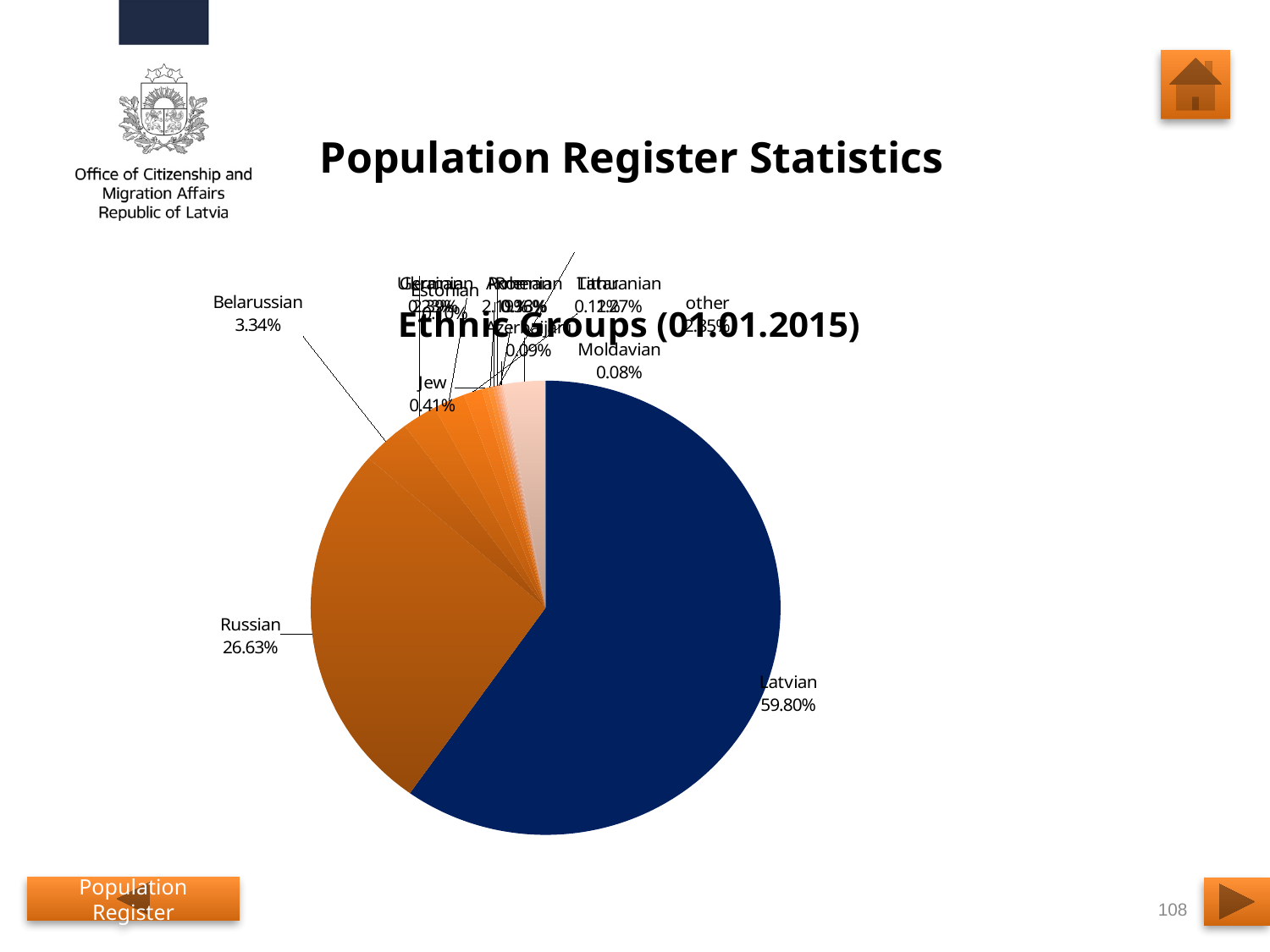
What share of the pie is Russian? 26.63% What kind of chart is shown on the slide? pie chart What is the value shown for Moldavian? 0.08% Which is larger, the Russian share or the Belarussian share? Russian What is the combined share of Latvian and Russian? 86.43% Which ethnic group has the largest share of the pie? Latvian What share of the pie is Latvian? 59.80% What is the value shown for Belarussian? 3.34% What is the difference between the Latvian and Russian shares? 33.17% What is the value shown for Jew? 0.41% What is the title of the chart? Ethnic Groups (01.01.2015) What colour is the Latvian slice of the pie? dark blue